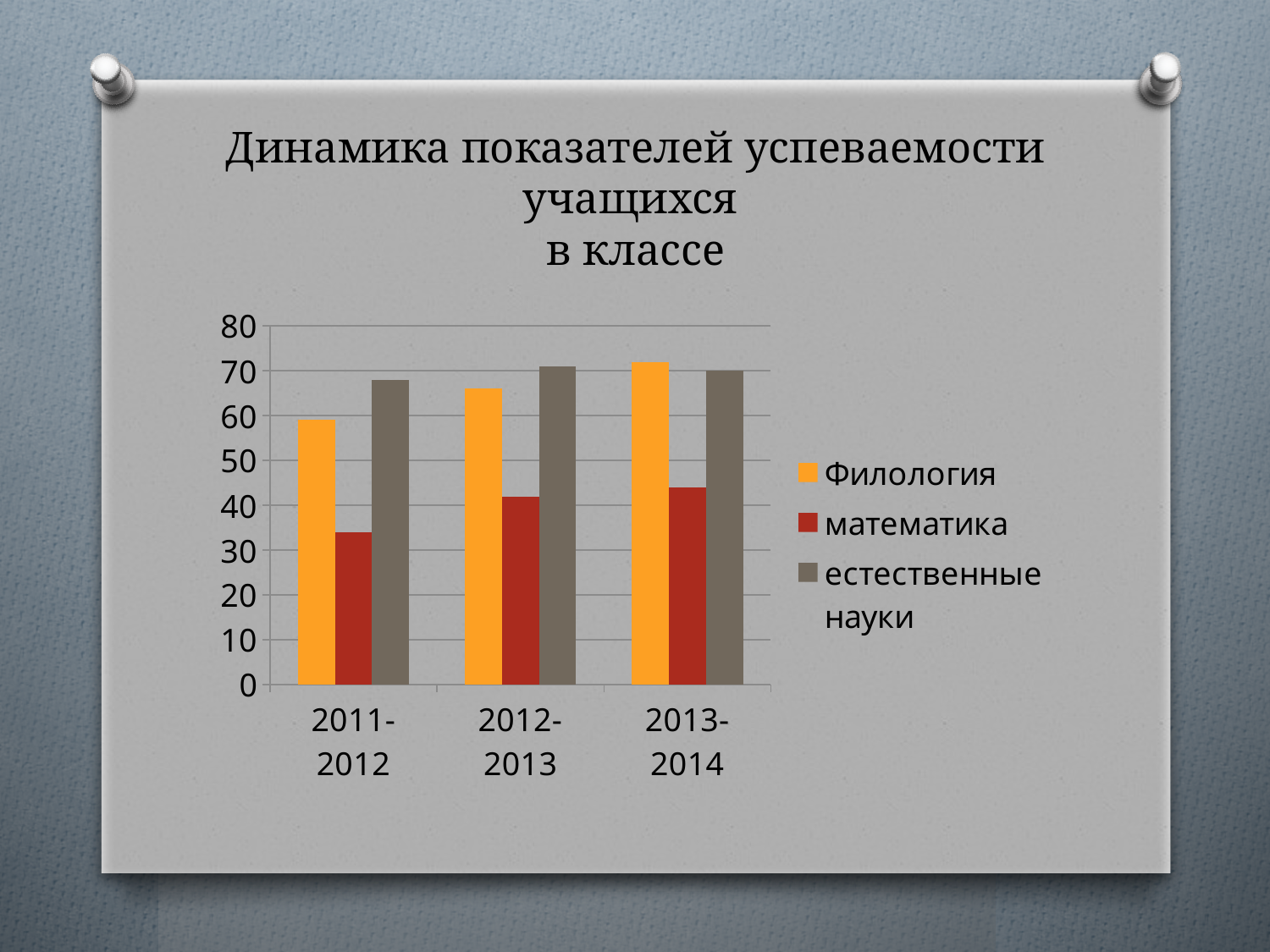
In which school year is the value for Филология highest? 2013-2014 Do the values for математика rise or fall from 2011-2012 to 2013-2014? rise What is the title of the chart? Динамика показателей успеваемости учащихся в классе Is the value for математика in 2011-2012 greater or less than 40? less Is the value for Филология in 2011-2012 greater or less than 50? greater Do the values for Филология rise or fall from 2011-2012 to 2013-2014? rise Which series has the lowest value in 2013-2014? математика How many school-year categories are shown on the x axis? 3 In 2011-2012, which is larger: Филология or математика? Филология How many series does the legend list? 3 What kind of chart is shown on the slide? bar chart Is the value for естественные науки in 2012-2013 greater or less than 60? greater